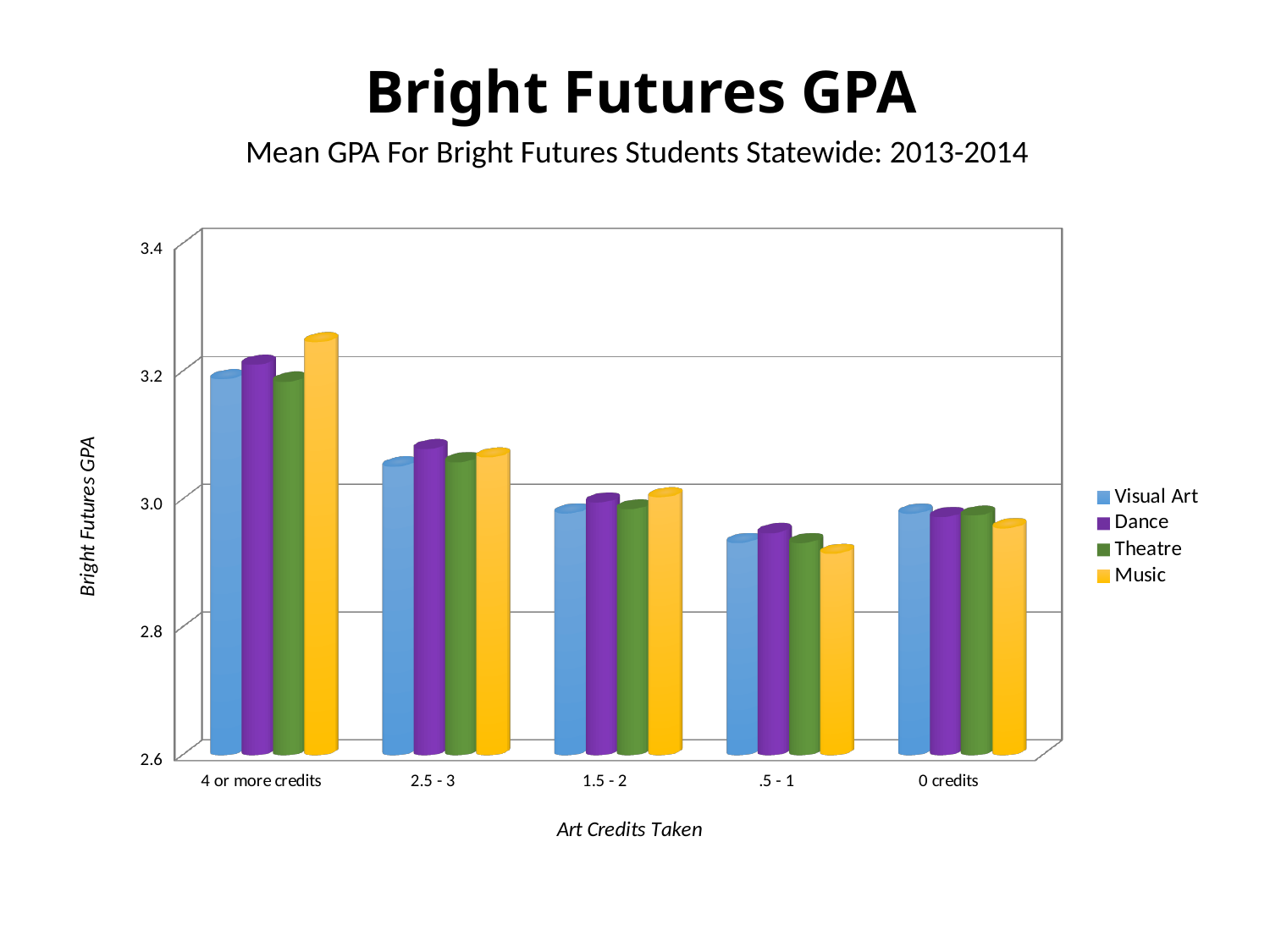
Is the Visual Art value for .5 - 1 credits greater or less than 3.0? less What is the title of the vertical axis? Bright Futures GPA Which art-credit category has the lowest bars overall? .5 - 1 What is the title of the horizontal axis? Art Credits Taken How many art-credit categories are shown on the x axis? 5 Is the Music value for 4 or more credits greater or less than 3.2? greater What kind of chart is shown on the slide? Bar chart Which is larger: the Visual Art value for 4 or more credits or the Visual Art value for 0 credits? 4 or more credits Which art-credit category has the highest Music bar? 4 or more credits Is the Dance value for 2.5 - 3 credits greater or less than 3.0? greater How many series does the legend list? 4 Do the Music values rise or fall from 4 or more credits to .5 - 1 credits? fall